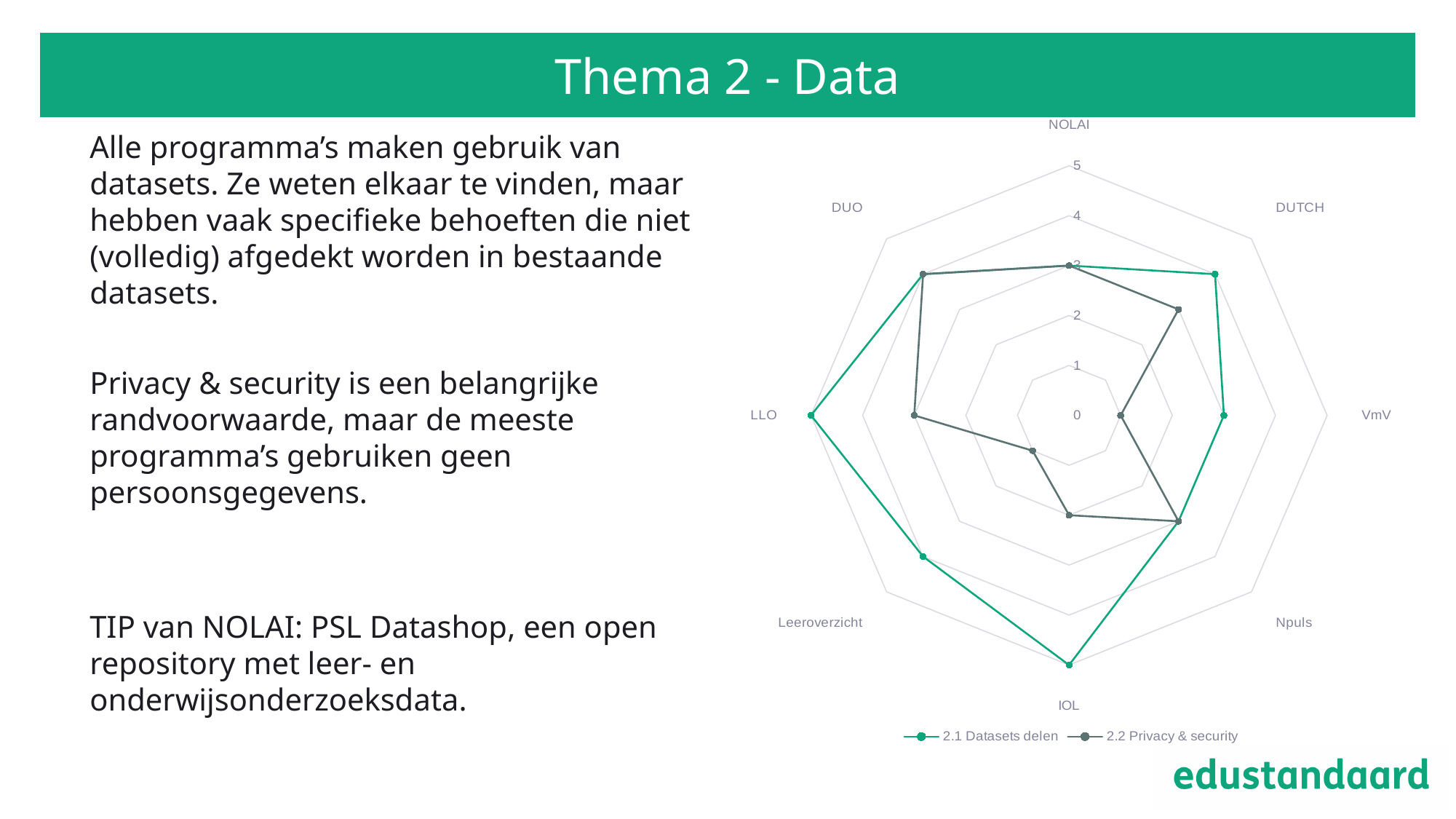
Which category has the lowest value in the series 2.2 Privacy & security? VmV and Leeroverzicht What is the maximum value shown on the radar chart's axis scale? 5 How many categories (axes) does the radar chart have? 8 How many series does the legend list? 2 What is the value for DUTCH in the series 2.1 Datasets delen? 4 What is the value for IOL in the series 2.1 Datasets delen? 5 What kind of chart is shown on the slide? Radar chart Which colour represents the series 2.1 Datasets delen? Green What is the value for VmV in the series 2.2 Privacy & security? 1 Is the value for IOL in the series 2.2 Privacy & security greater or less than 4? less What is the difference between the 2.1 Datasets delen and 2.2 Privacy & security values for Leeroverzicht? 3 For LLO, which series has the larger value: 2.1 Datasets delen or 2.2 Privacy & security? 2.1 Datasets delen